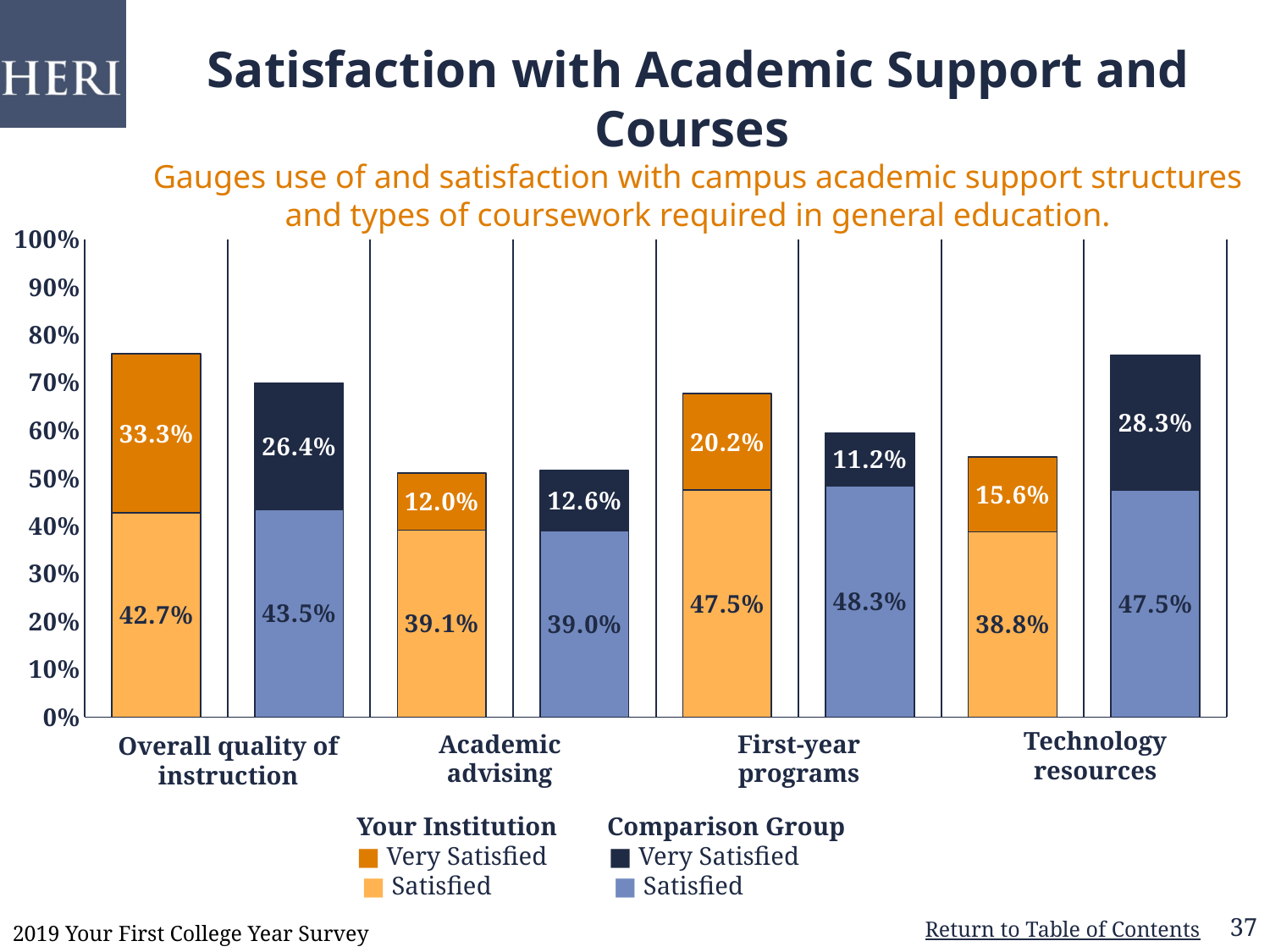
What percentage of the Comparison Group were Satisfied with Technology resources? 47.5% Across the four categories, which has the lowest Very Satisfied percentage for Your Institution? Academic advising How many entries does the chart legend list? 4 What is the difference between the Comparison Group's and Your Institution's Very Satisfied percentages for First-year programs? 9.0% How many categories are shown along the x axis of the chart? 4 What is the combined Satisfied plus Very Satisfied total for the Comparison Group on Technology resources? 75.8% Across the four categories, which has the highest Very Satisfied percentage for the Comparison Group? Technology resources What type of chart is shown on the slide? Stacked bar chart What percentage of Your Institution respondents were Satisfied with Academic advising? 39.1% For Technology resources, which group has the larger Satisfied percentage, Your Institution or the Comparison Group? Comparison Group What percentage of Your Institution respondents were Very Satisfied with Overall quality of instruction? 33.3% What is the combined Satisfied plus Very Satisfied total for Your Institution on Overall quality of instruction? 76.0%